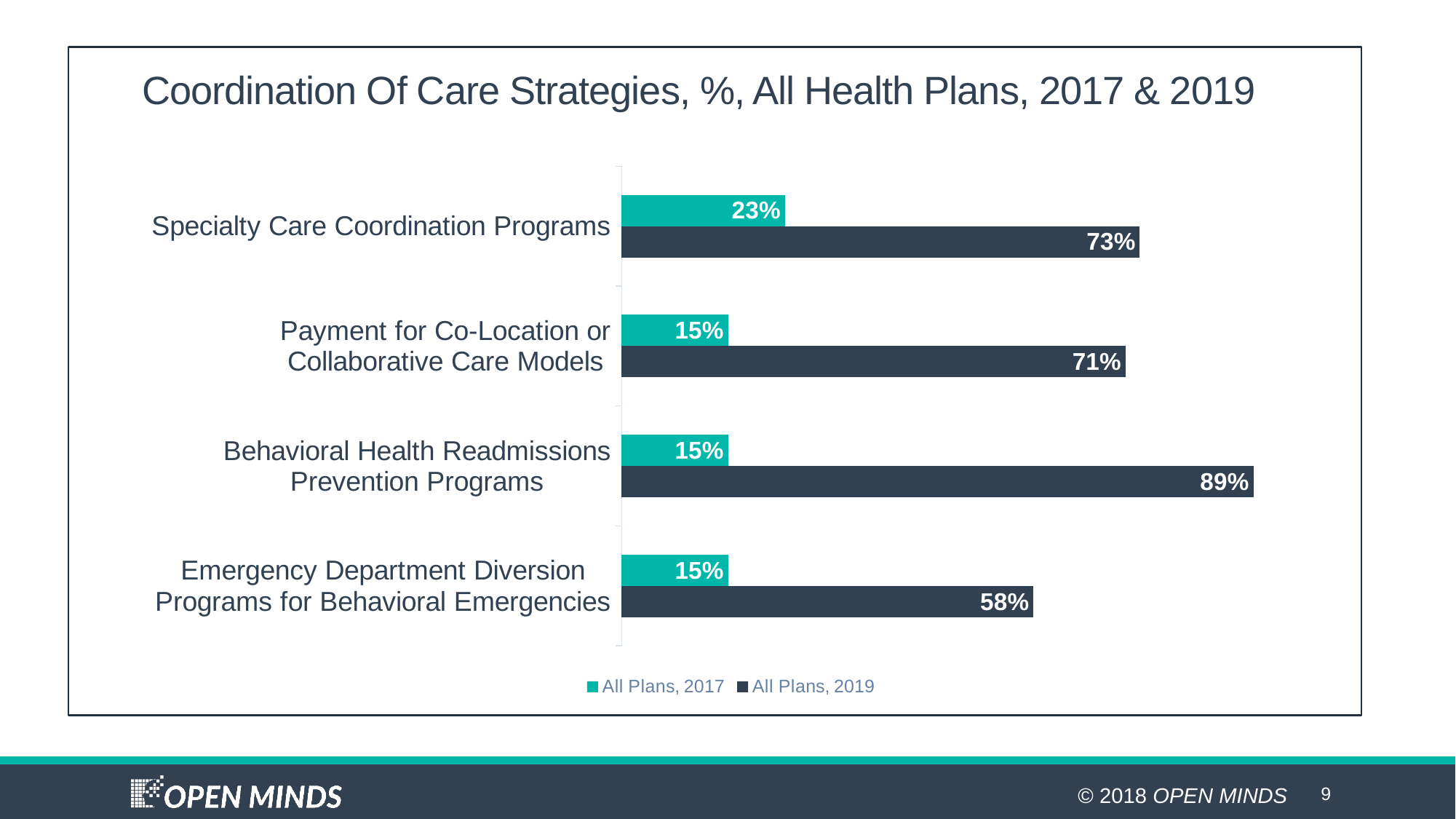
Which is larger: the All Plans, 2019 value for Payment for Co-Location or Collaborative Care Models or the All Plans, 2019 value for Specialty Care Coordination Programs? Specialty Care Coordination Programs Which category has the highest value in the All Plans, 2019 series? Behavioral Health Readmissions Prevention Programs What kind of chart is shown on the slide? Bar chart What is the value for Emergency Department Diversion Programs for Behavioral Emergencies in the All Plans, 2019 series? 58% Which category has the lowest value in the All Plans, 2019 series? Emergency Department Diversion Programs for Behavioral Emergencies What is the difference between the All Plans, 2019 and All Plans, 2017 values for Specialty Care Coordination Programs? 50% How many series does the legend list? 2 Which category has the highest value in the All Plans, 2017 series? Specialty Care Coordination Programs What is the difference between the All Plans, 2019 values for Behavioral Health Readmissions Prevention Programs and Emergency Department Diversion Programs for Behavioral Emergencies? 31% What is the value for Behavioral Health Readmissions Prevention Programs in the All Plans, 2017 series? 15% How many categories are shown on the chart? 4 What is the value for Specialty Care Coordination Programs in the All Plans, 2019 series? 73%